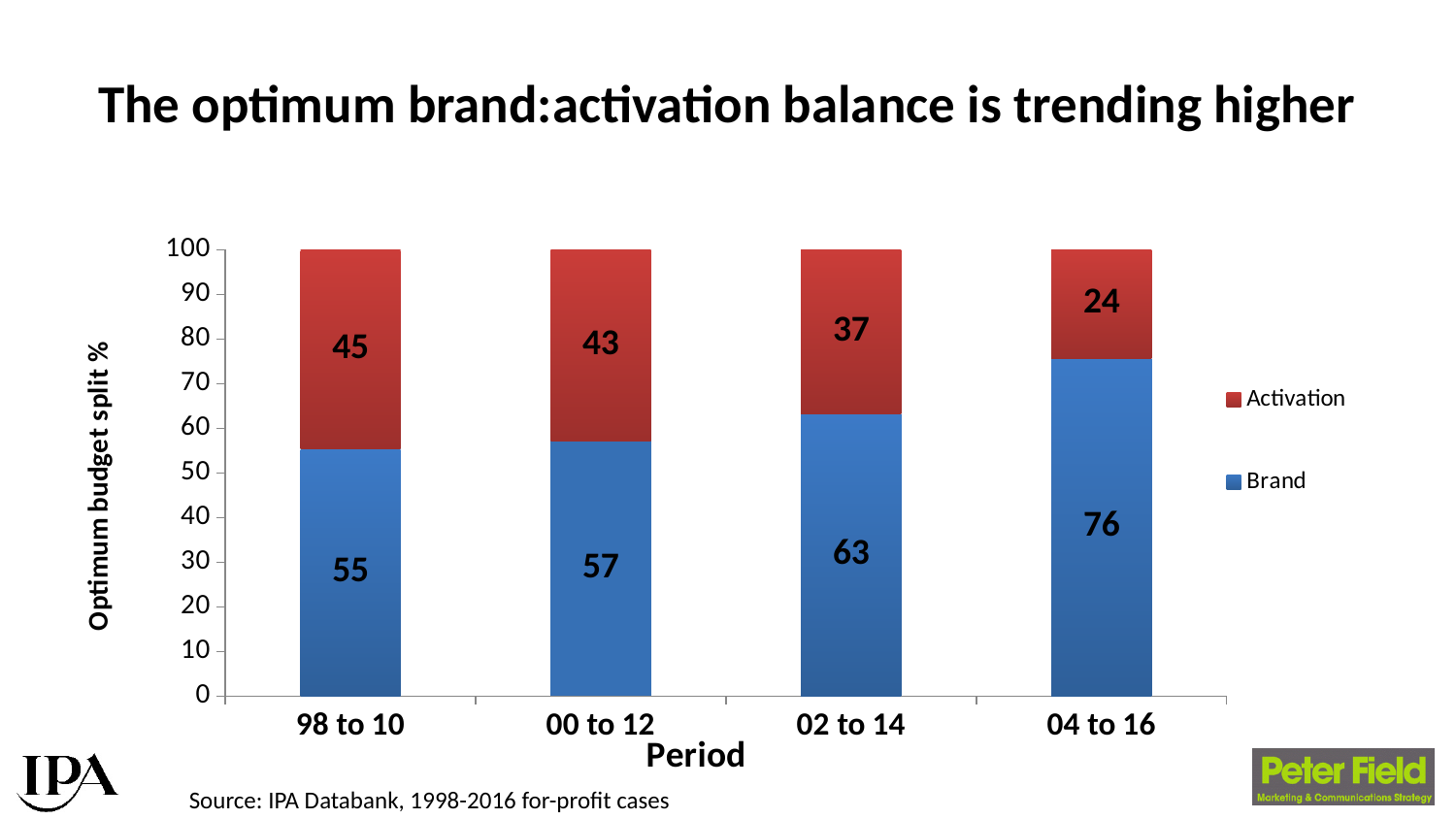
What is the difference between the Brand values for 04 to 16 and 98 to 10? 21 How many periods are shown on the x axis? 4 What is the Activation value for the period 04 to 16? 24 What is the Brand value for the period 02 to 14? 63 How many series does the legend list? 2 Which period has the lowest Activation value? 04 to 16 Which is larger: the Activation value for 00 to 12 or for 02 to 14? 00 to 12 Which period has the highest Brand value? 04 to 16 What is the total of the stacked bar for the period 00 to 12? 100 What is the Brand value for the period 98 to 10? 55 What kind of chart is shown on the slide? Stacked bar chart Does the Brand value rise or fall across the periods from 98 to 10 through 04 to 16? Rise